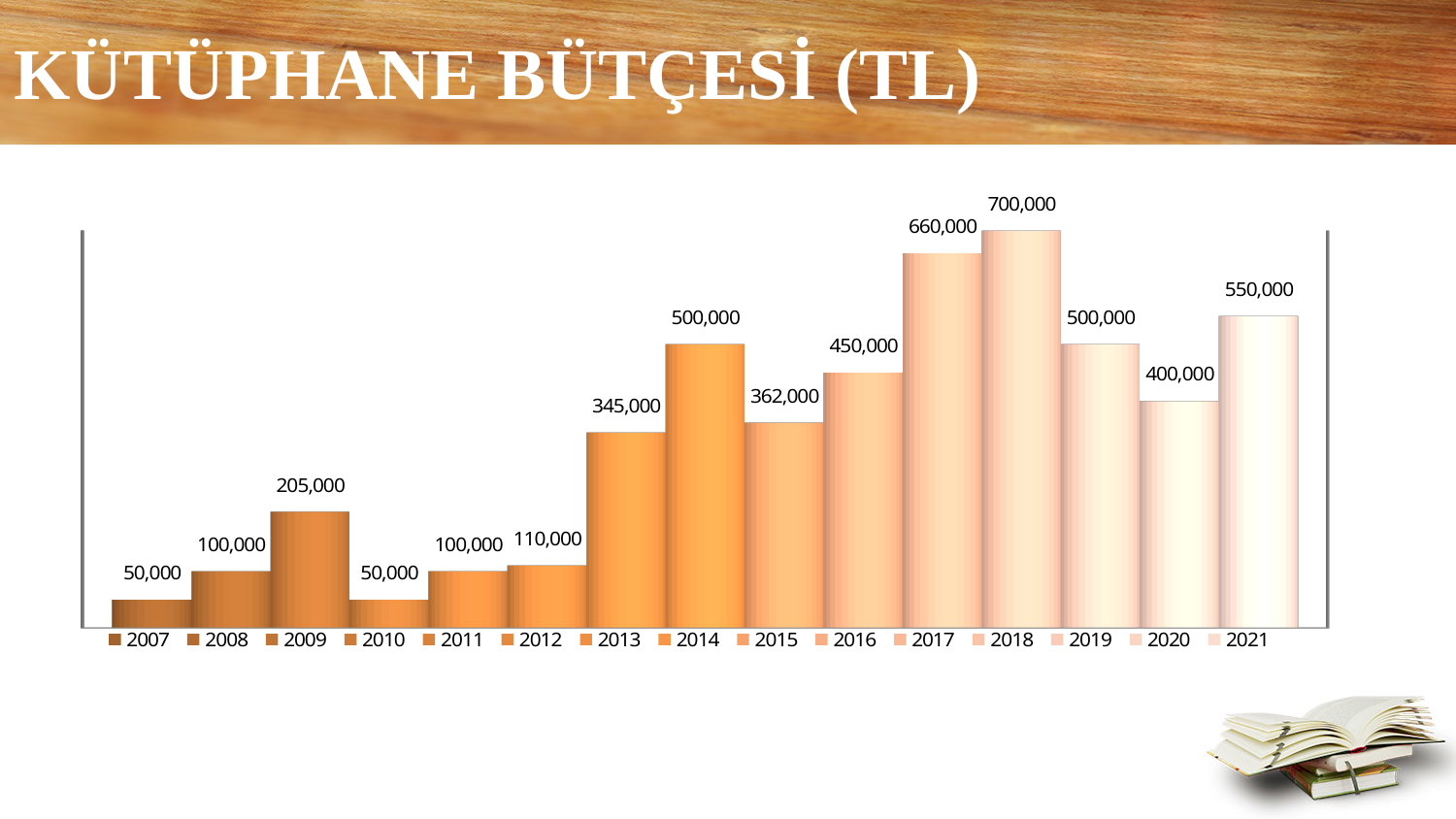
What type of chart is shown on the slide? Bar chart What is the difference between the 2018 budget and the 2017 budget? 40,000 Did the library budget rise or fall from 2018 to 2020? Fall Which year has the highest library budget? 2018 What is the library budget for 2018? 700,000 What is the title of the slide? KÜTÜPHANE BÜTÇESİ (TL) What is the library budget for 2014? 500,000 Which is larger, the budget for 2009 or the budget for 2012? 2009 Which is larger, the budget for 2015 or the budget for 2016? 2016 What is the difference between the 2021 budget and the 2020 budget? 150,000 How many years are shown in the chart? 15 What is the library budget for 2021? 550,000